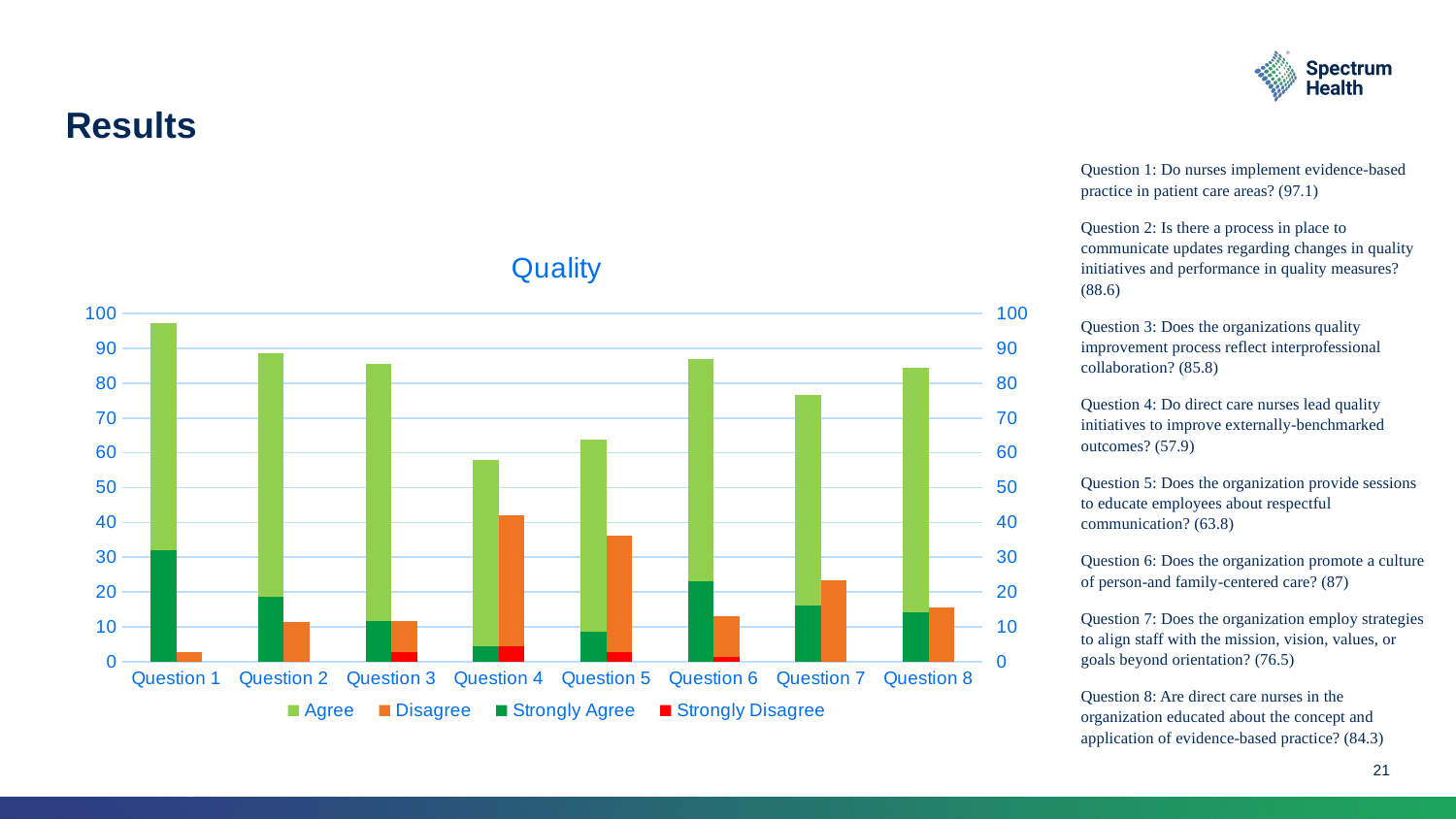
Is the Agree value for Question 4 greater or less than 60? less Is the Agree value for Question 1 greater or less than 90? greater Which question has the highest Disagree value? Question 4 What type of chart is shown on the slide? bar chart Which question has the lowest Agree value? Question 4 Which is larger, the Agree value for Question 2 or the Agree value for Question 7? Question 2 Which question has the highest Agree value? Question 1 How many series does the chart's legend list? 4 How many questions (categories) are shown on the x axis of the chart? 8 What is the title of the chart? Quality Which question has the highest Strongly Agree value? Question 1 What colour represents the Disagree series in the chart? orange